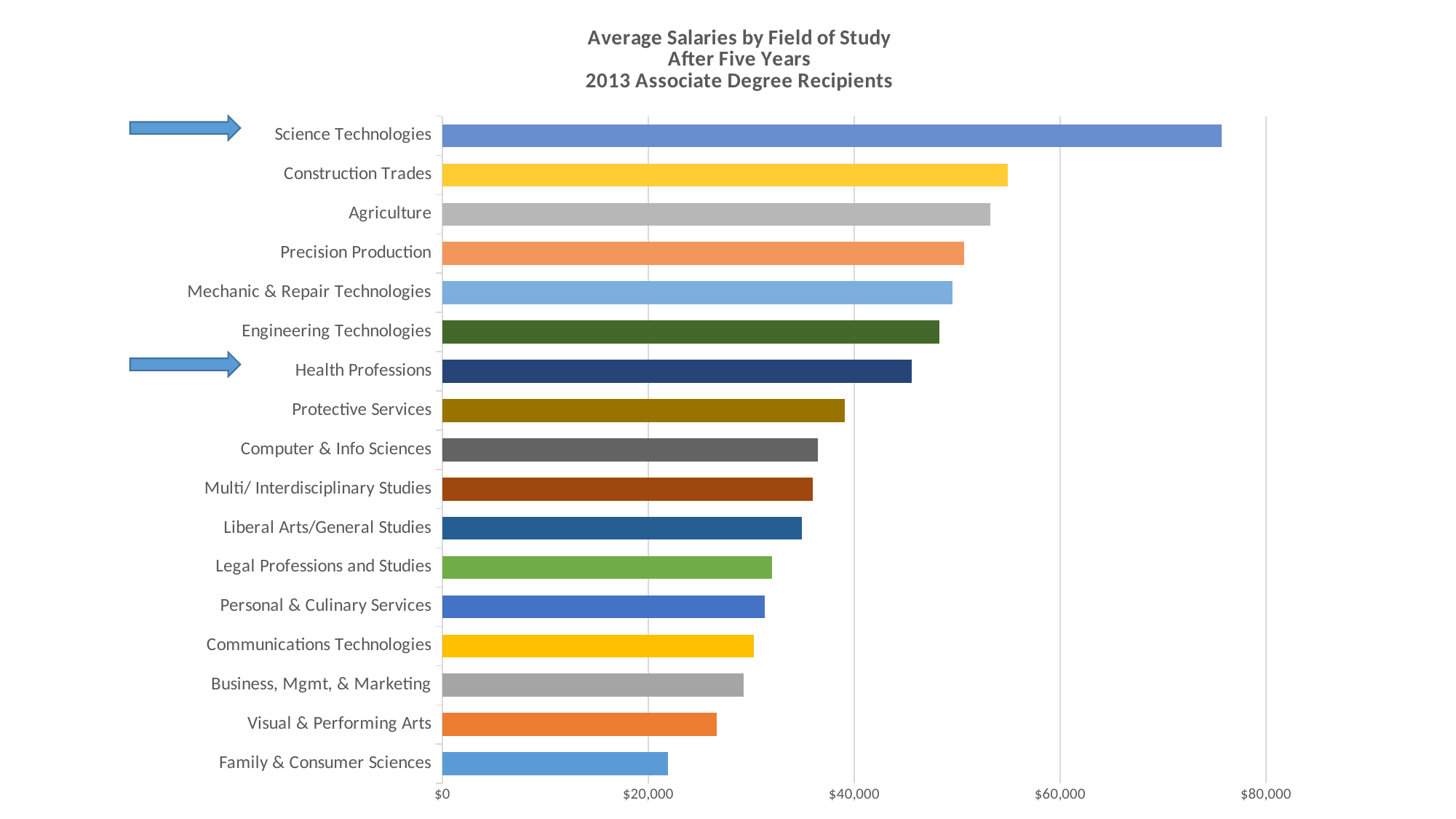
Is the value for Business, Mgmt, & Marketing greater or less than $40,000? less Which is larger, the value for Engineering Technologies or the value for Liberal Arts/General Studies? Engineering Technologies Is the value for Health Professions greater or less than $40,000? greater How many fields of study are shown in the chart? 17 Is the value for Science Technologies greater or less than $60,000? greater What is the title of the chart? Average Salaries by Field of Study After Five Years 2013 Associate Degree Recipients Which field of study has the lowest average salary? Family & Consumer Sciences Which field of study has the highest average salary? Science Technologies What kind of chart is shown on the slide? bar chart Which is larger, the value for Health Professions or the value for Protective Services? Health Professions